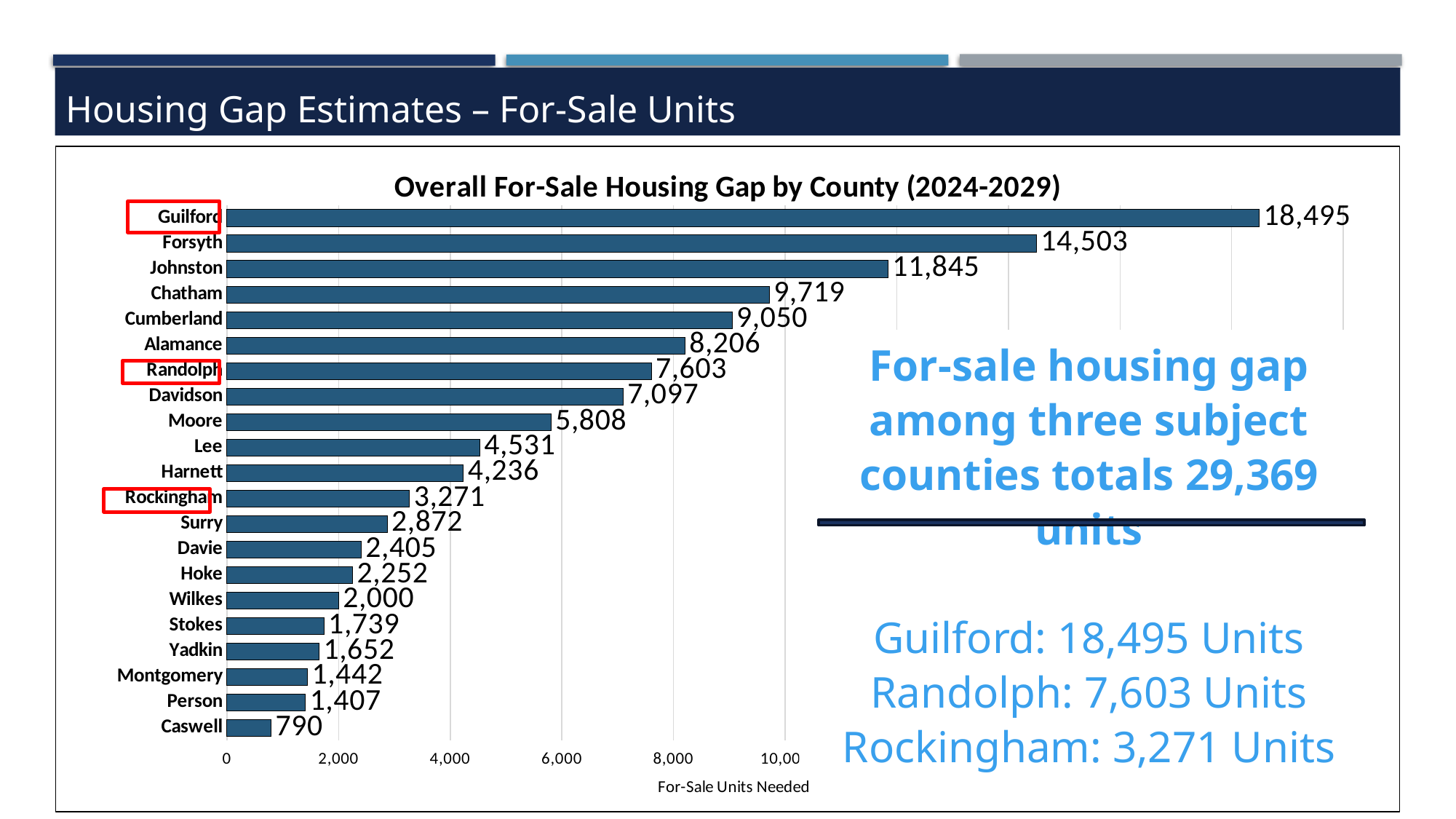
What is the for-sale housing gap for Caswell County? 790 Which county has a larger for-sale housing gap, Chatham or Cumberland? Chatham What type of chart is used to show the for-sale housing gap by county? Bar chart Which county has the highest for-sale housing gap? Guilford What is the title of the chart? Overall For-Sale Housing Gap by County (2024-2029) How many counties are shown in the chart? 21 What is the difference between the for-sale housing gap of Guilford and Forsyth? 3,992 Which county has the lowest for-sale housing gap? Caswell What is the for-sale housing gap for Johnston County? 11,845 What is the combined for-sale housing gap of the three subject counties (Guilford, Randolph, Rockingham)? 29,369 What is the for-sale housing gap for Moore County? 5,808 What is the difference between the for-sale housing gap of Randolph and Rockingham? 4,332